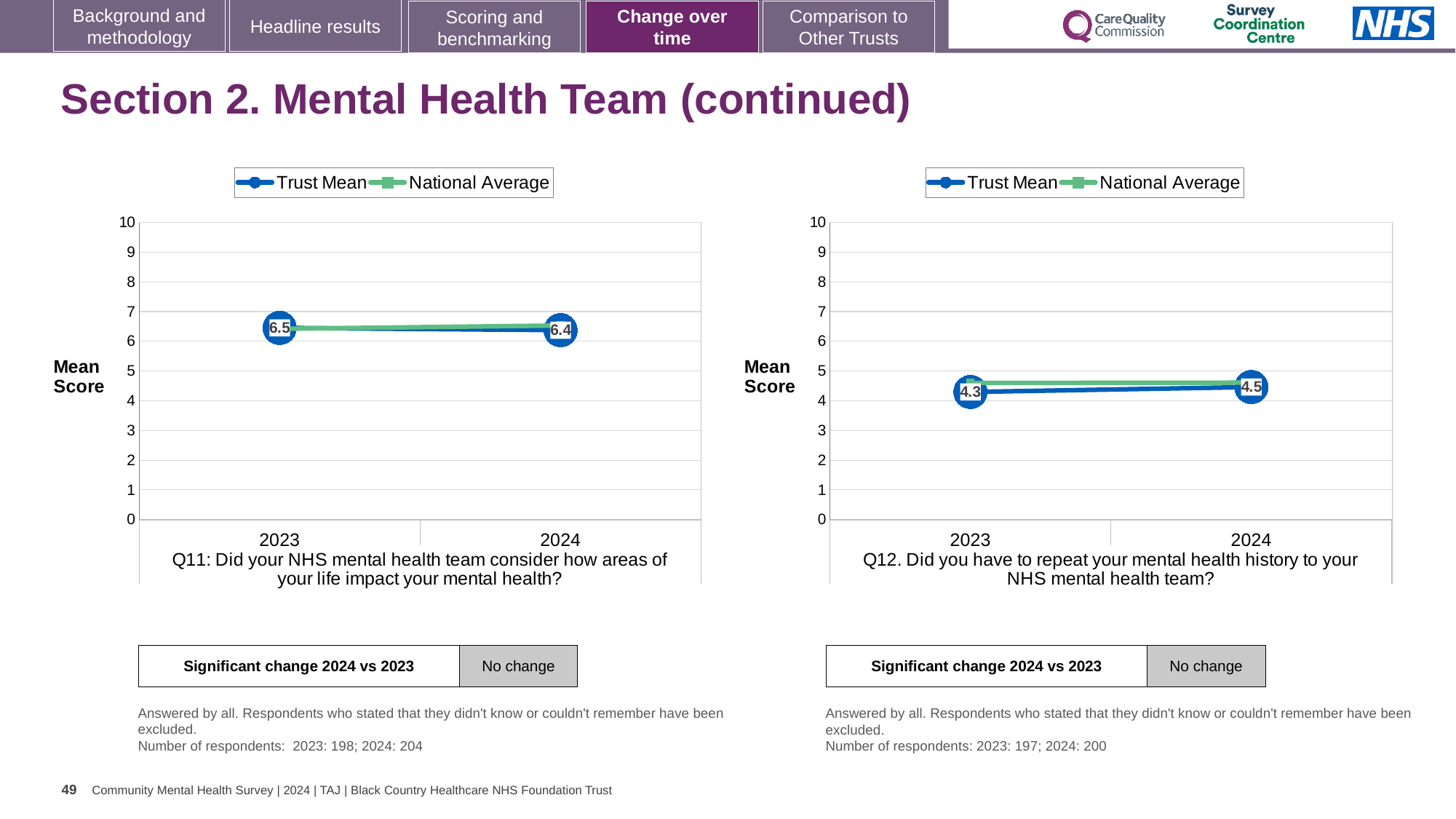
On the Q12 chart (right), which year has the higher Trust Mean, 2023 or 2024? 2024 How many series does the legend of the Q12 chart (right) list? 2 How many years are plotted on the x axis of the Q11 chart (left)? 2 What type of chart is used for Q11 (left)? Line chart On the Q12 chart (right), does the Trust Mean rise or fall from 2023 to 2024? rise On the Q12 chart (right), by how much did the Trust Mean change from 2023 to 2024? 0.2 On the Q11 chart (left), what is the Trust Mean for 2024? 6.4 On the Q11 chart (left), does the Trust Mean rise or fall from 2023 to 2024? fall On the Q12 chart (right), what is the Trust Mean for 2024? 4.5 On the Q11 chart (left), is the Trust Mean for 2023 greater or less than 6? greater On the Q12 chart (right), what is the Trust Mean for 2023? 4.3 On the Q11 chart (left), what is the Trust Mean for 2023? 6.5